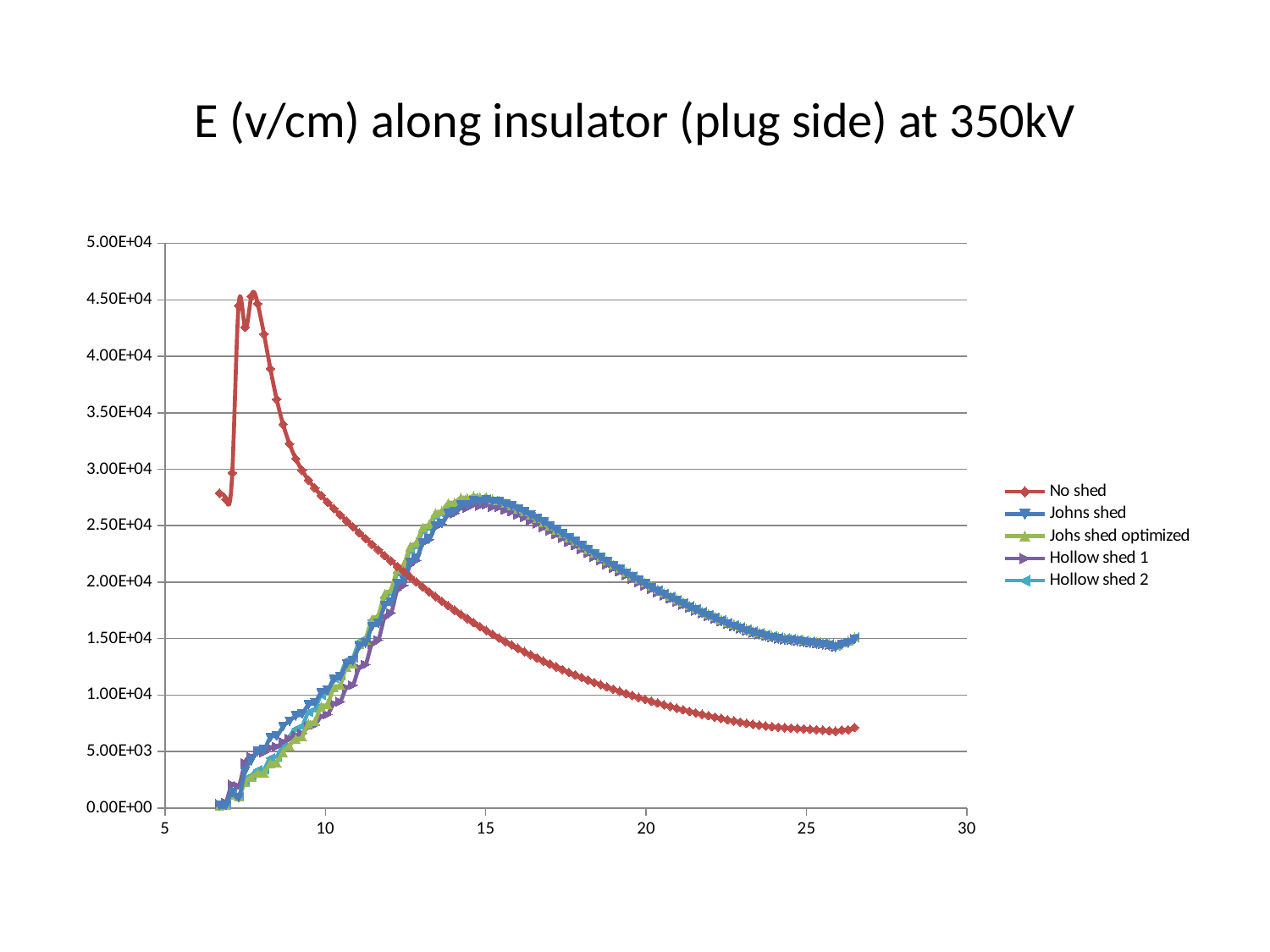
At x = 10, which series has the higher value: No shed or Hollow shed 1? No shed Is the value of the No shed series at x = 25 greater or less than 1.00E+04? less How many series does the legend list? 5 Which series reaches the highest peak value on the chart? No shed What kind of chart is shown on the slide? line chart At x = 20, which series has the higher value: No shed or Johns shed? Johns shed Which series is drawn in red with diamond markers? No shed Is the value of the Johns shed series at x = 10 greater or less than 1.50E+04? less What is the title of the chart? E (v/cm) along insulator (plug side) at 350kV Is the peak value of the No shed series greater or less than 4.00E+04? greater Between x = 10 and x = 25, does the No shed series rise or fall? fall